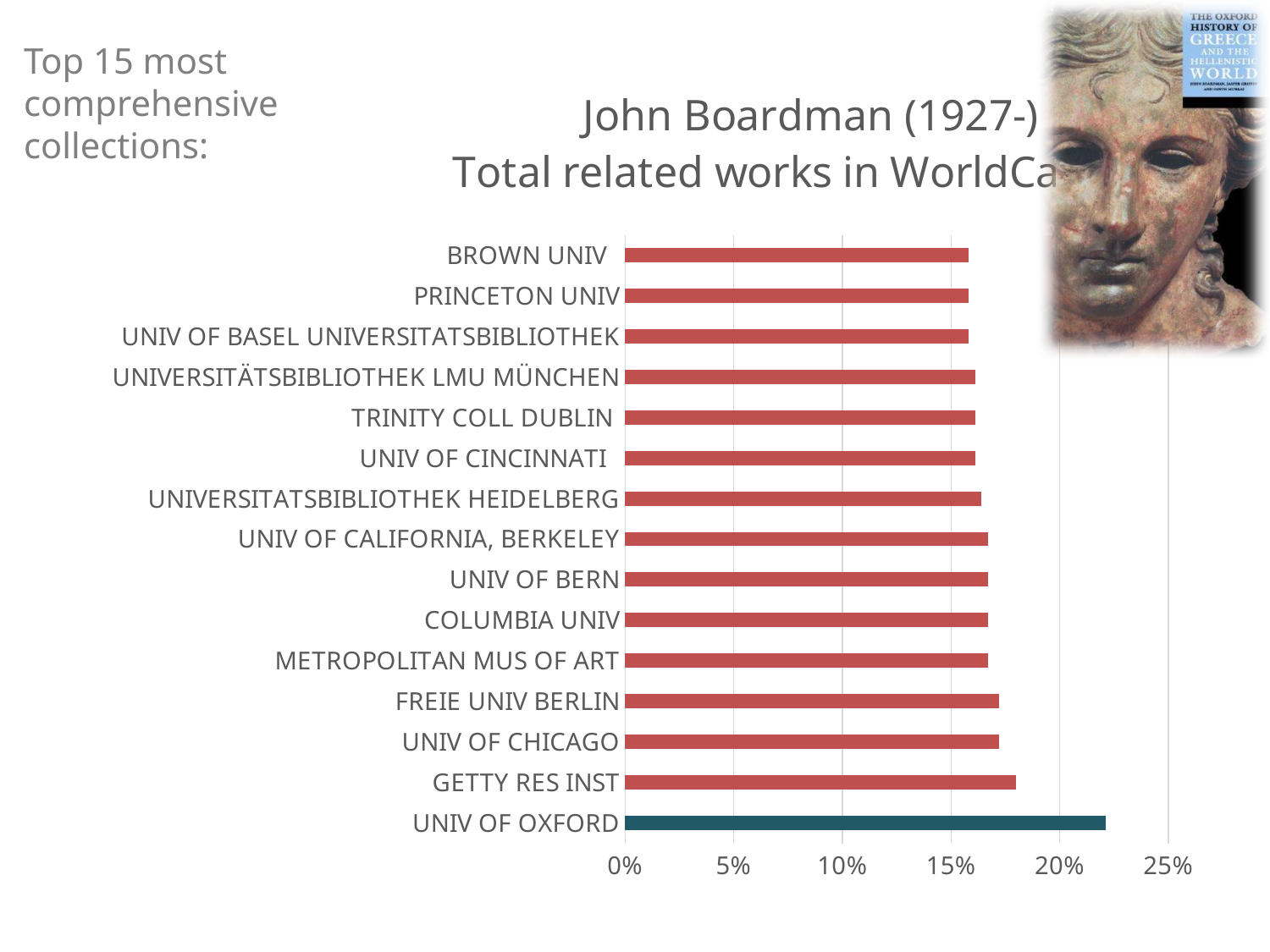
Which is larger, the value for GETTY RES INST or the value for BROWN UNIV? GETTY RES INST What kind of chart is shown on the slide? bar chart Which institution has the highest share of total related works in WorldCat? UNIV OF OXFORD Which institution's bar is coloured differently (dark teal) from the others? UNIV OF OXFORD Which is larger, the value for UNIV OF OXFORD or the value for GETTY RES INST? UNIV OF OXFORD Is the value for BROWN UNIV greater or less than 20%? less Is the value for GETTY RES INST greater or less than 15%? greater Is the value for UNIV OF OXFORD greater or less than 20%? greater How many institutions are listed on the chart? 15